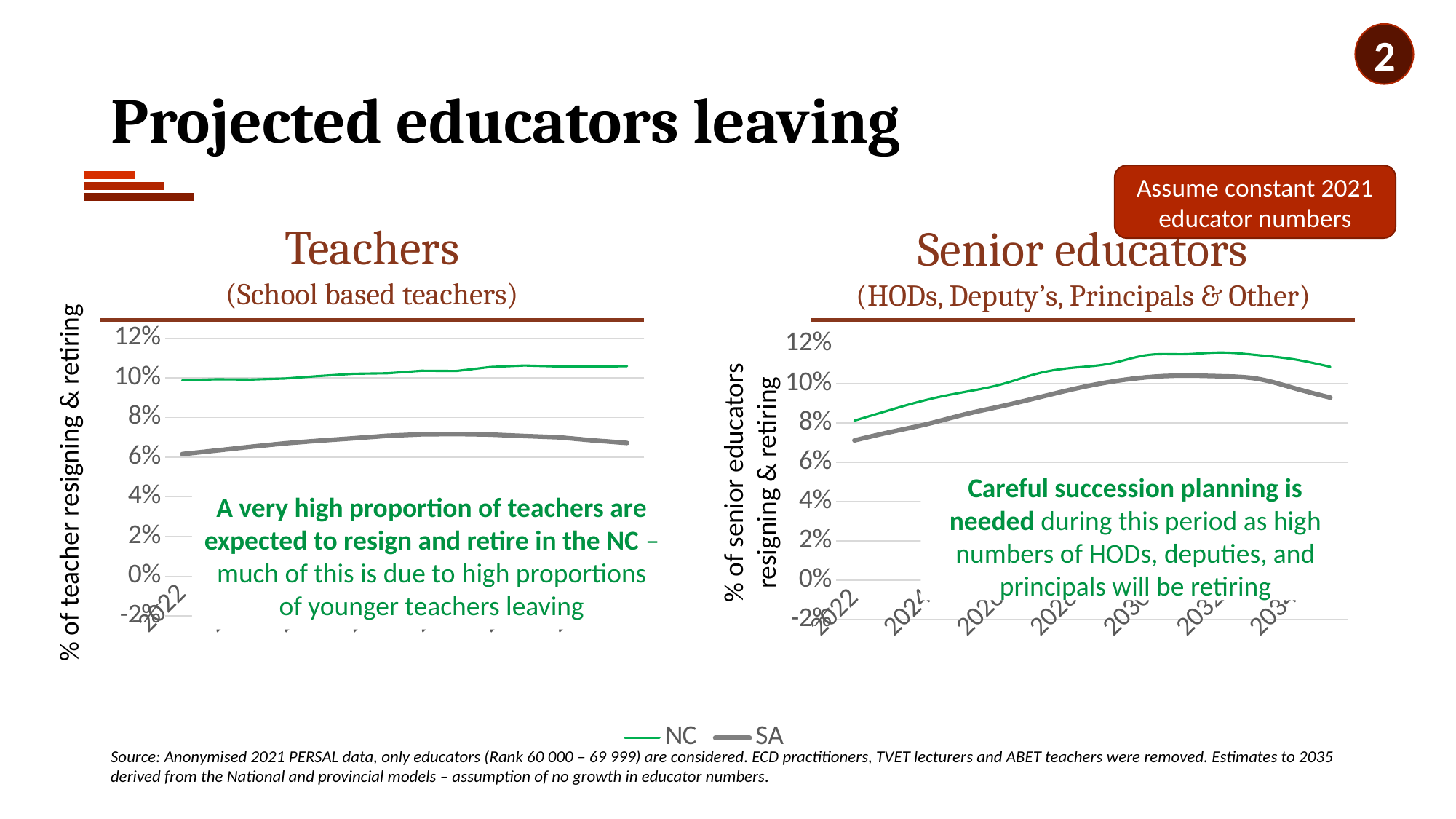
What are the two series named in the legend? NC and SA In the Teachers chart, is the highest value of the SA line greater or less than 8%? less In the Senior educators chart, is the peak value of the NC line greater or less than 12%? less In the Senior educators chart, is the peak value of the NC line greater or less than 10%? greater How many series does the legend list? 2 What is the subtitle under the Senior educators chart title? (HODs, Deputy's, Principals & Other) In the Senior educators chart, which series is higher in 2022, NC or SA? NC What type of chart is the Teachers chart? line chart In the Teachers chart, which series is higher throughout, NC or SA? NC In the Senior educators chart, does the SA line rise or fall between 2022 and 2030? rise In the Senior educators chart, does the SA line rise or fall between 2032 and 2034? fall